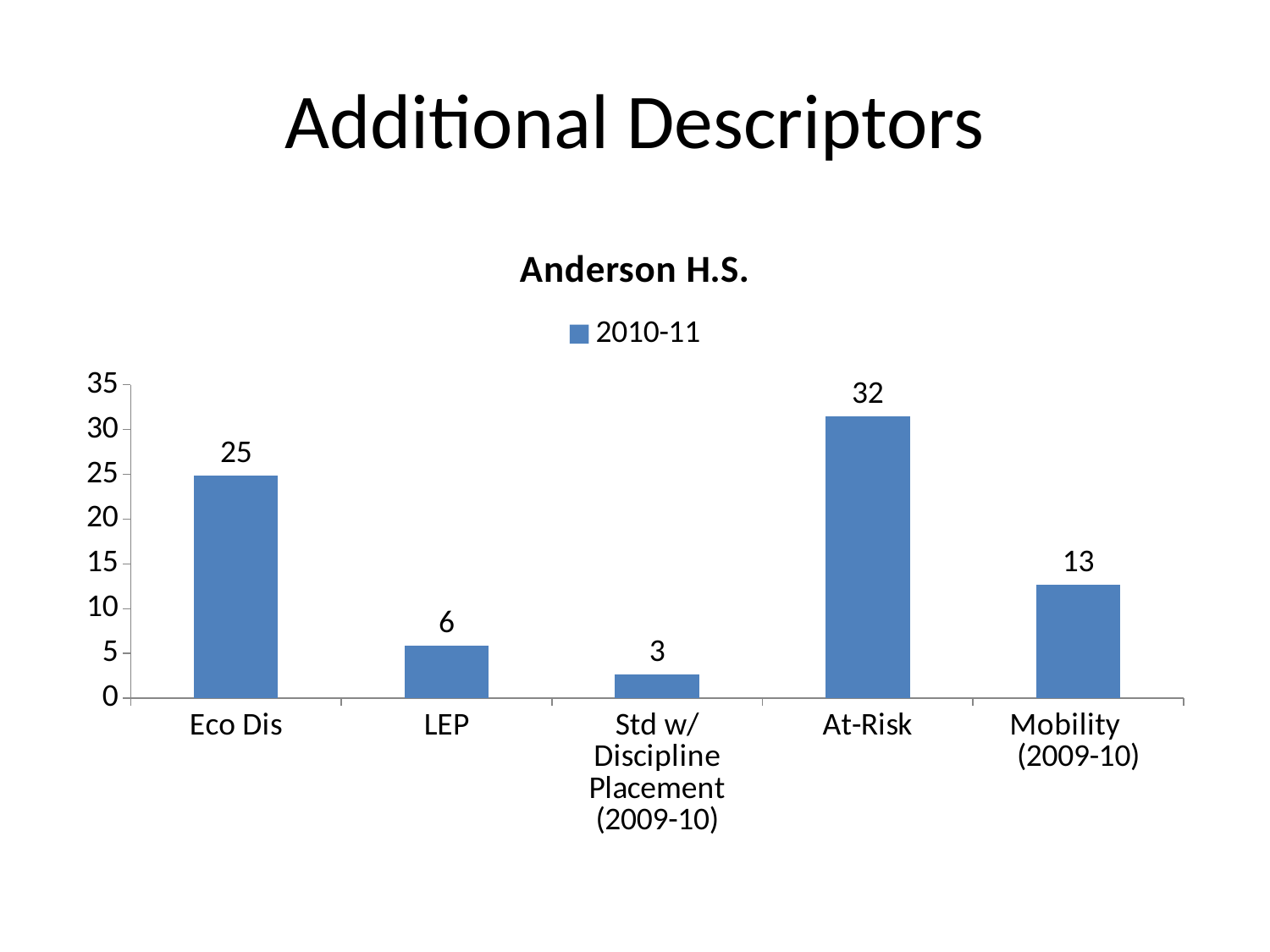
Which category has the highest value? At-Risk What is the value for Std w/ Discipline Placement (2009-10)? 3 Which category has the lowest value? Std w/ Discipline Placement (2009-10) What is the value for Eco Dis? 25 Is the value for At-Risk greater or less than 30? greater What kind of chart is shown on the slide? bar chart What is the difference between the values for At-Risk and Eco Dis? 7 What is the value for Mobility (2009-10)? 13 How many categories are shown on the x axis? 5 What is the value for LEP? 6 How many series does the legend list? 1 Which is larger, the value for Mobility (2009-10) or the value for LEP? Mobility (2009-10)